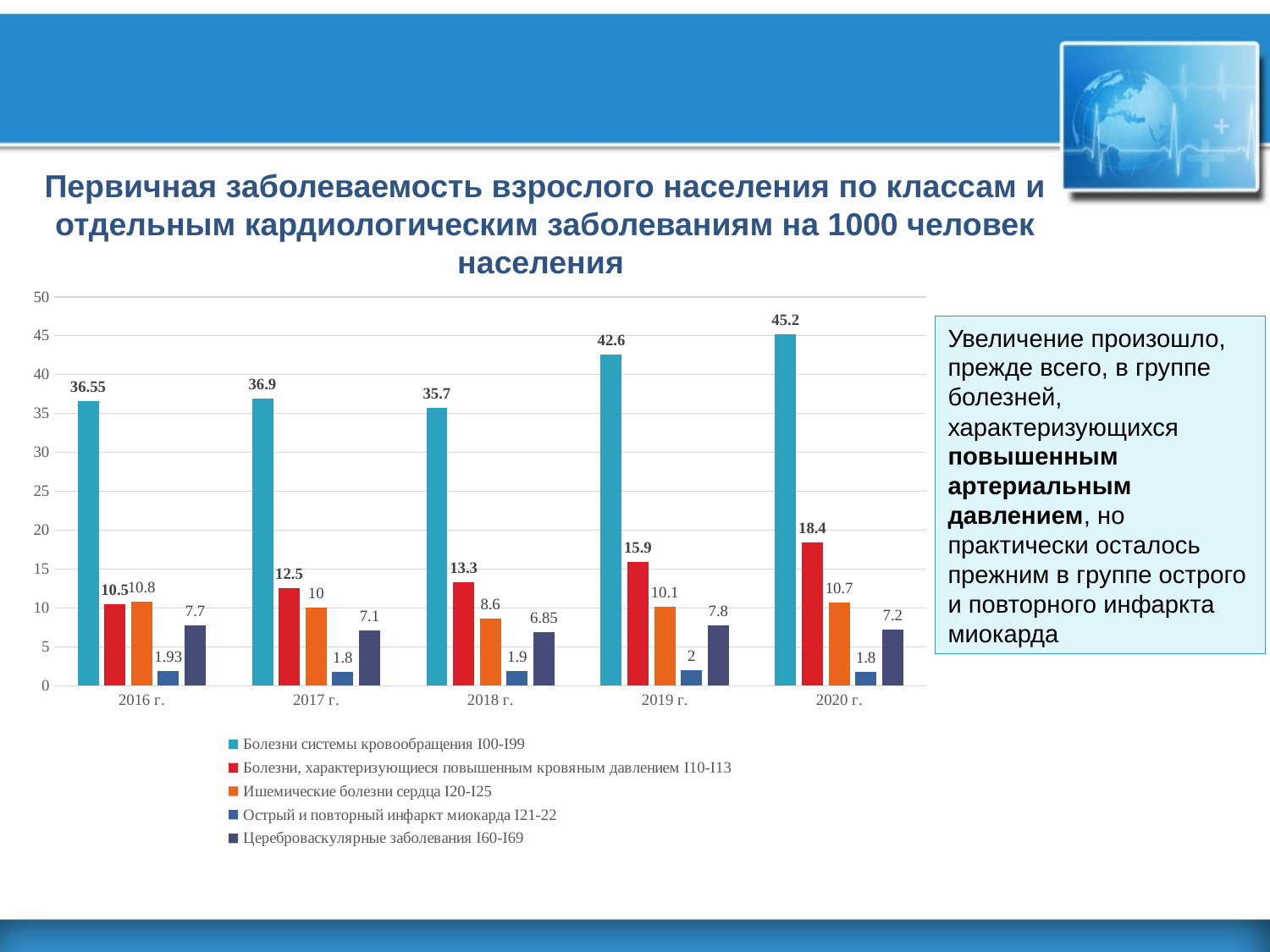
What is the value for Острый и повторный инфаркт миокарда I21-22 in 2016 г.? 1.93 How many series does the legend list? 5 What is the value for Болезни, характеризующиеся повышенным кровяным давлением I10-I13 in 2017 г.? 12.5 How many years are shown on the x axis? 5 What is the value for Цереброваскулярные заболевания I60-I69 in 2018 г.? 6.85 Does the value for Болезни, характеризующиеся повышенным кровяным давлением I10-I13 rise or fall from 2016 г. to 2020 г.? rise What kind of chart is shown on the slide? bar chart Which is larger in 2016 г.: Болезни, характеризующиеся повышенным кровяным давлением I10-I13 or Ишемические болезни сердца I20-I25? Ишемические болезни сердца I20-I25 In which year is the value for Болезни, характеризующиеся повышенным кровяным давлением I10-I13 the highest? 2020 г. What is the difference between the values for Болезни системы кровообращения I00-I99 in 2020 г. and 2019 г.? 2.6 In which year is the value for Болезни системы кровообращения I00-I99 the lowest? 2018 г. What is the value for Болезни системы кровообращения I00-I99 in 2020 г.? 45.2